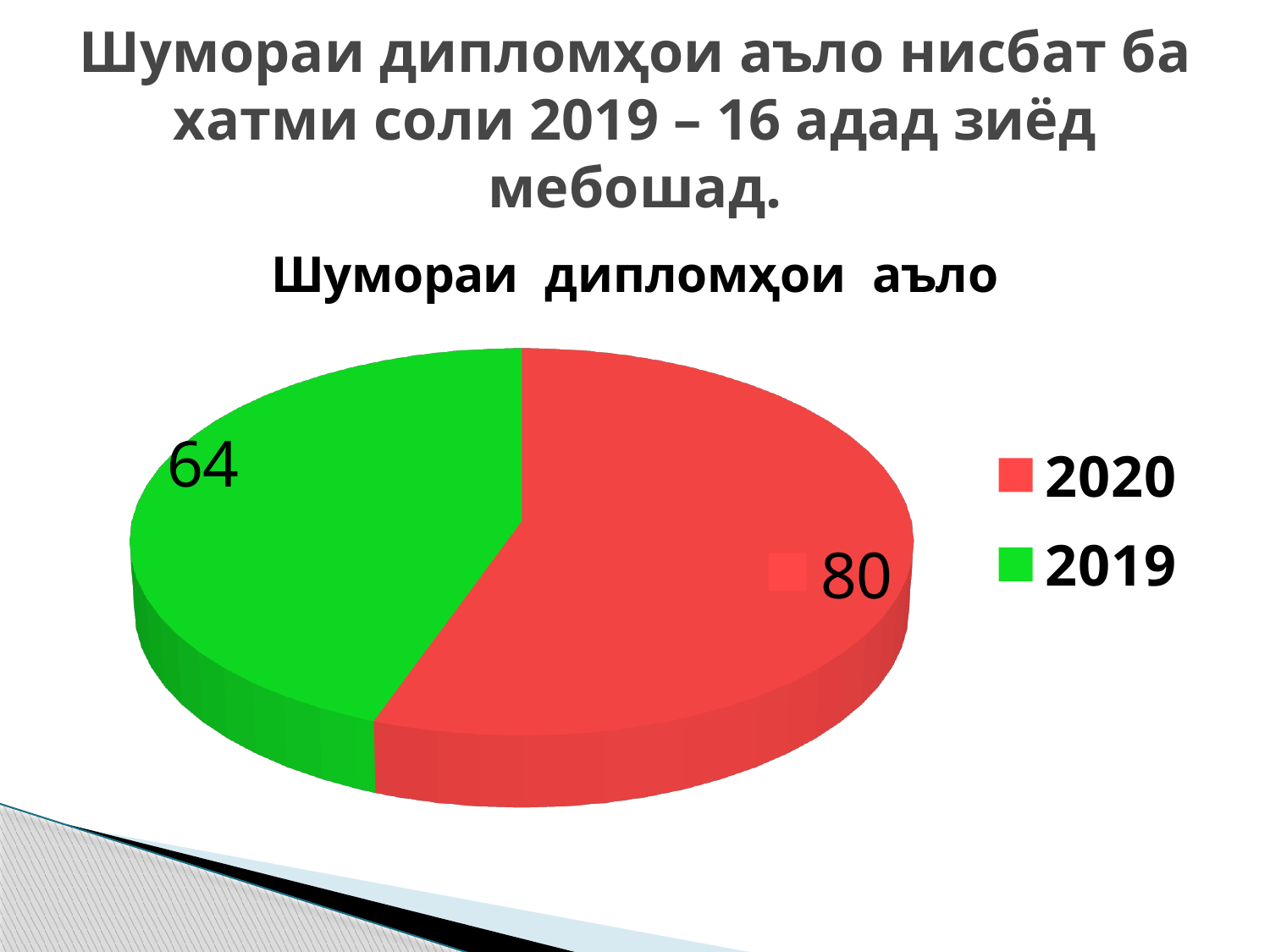
Which year has the smaller slice in the pie chart? 2019 How many slices does the pie chart have? 2 Which colour represents 2019 in the pie chart? green How many entries does the legend of the chart list? 2 What is the title of the chart on the slide? Шумораи дипломҳои аъло What is the difference between the values for 2020 and 2019 in the pie chart? 16 Is the value for 2020 larger or smaller than the value for 2019? larger What kind of chart is shown on the slide? pie chart What is the value for 2020 in the pie chart? 80 What is the total of the two values shown in the pie chart? 144 Which year has the larger slice in the pie chart? 2020 What is the value for 2019 in the pie chart? 64